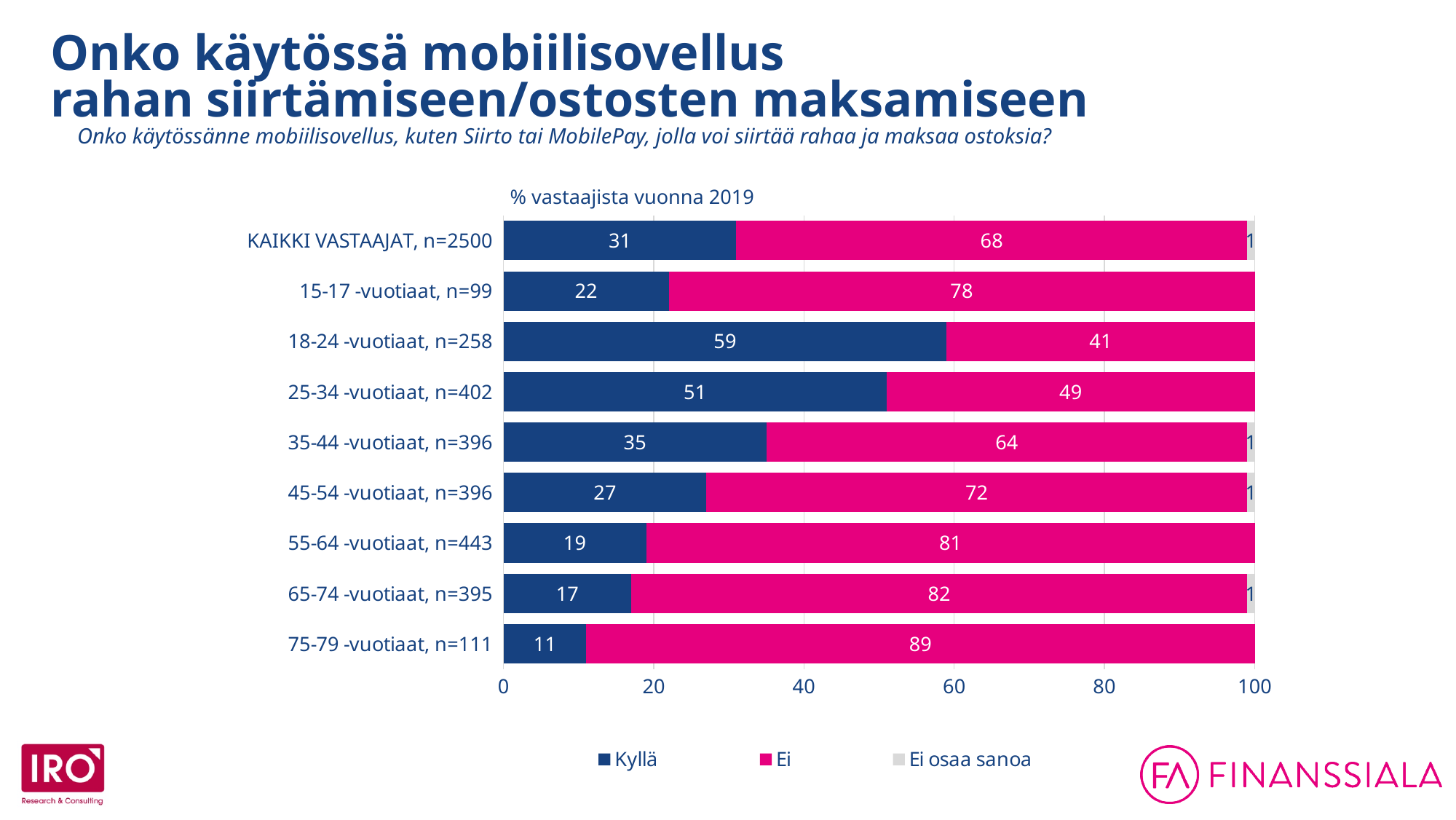
What is the Ei value for 55-64 -vuotiaat, n=443? 81 How many categories are shown on the chart? 9 Which category has the lowest Kyllä value? 75-79 -vuotiaat, n=111 What is the axis title shown above the chart? % vastaajista vuonna 2019 What kind of chart is shown on the slide? Stacked bar chart Which age group has the highest Kyllä value? 18-24 -vuotiaat, n=258 Which is larger for 25-34 -vuotiaat, n=402: the Kyllä value or the Ei value? Kyllä What is the Ei osaa sanoa value for KAIKKI VASTAAJAT, n=2500? 1 How many series does the legend list? 3 What is the difference between the Ei value and the Kyllä value for 45-54 -vuotiaat, n=396? 45 What is the total of the stacked bar for 35-44 -vuotiaat, n=396? 100 What is the Kyllä value for 18-24 -vuotiaat, n=258? 59